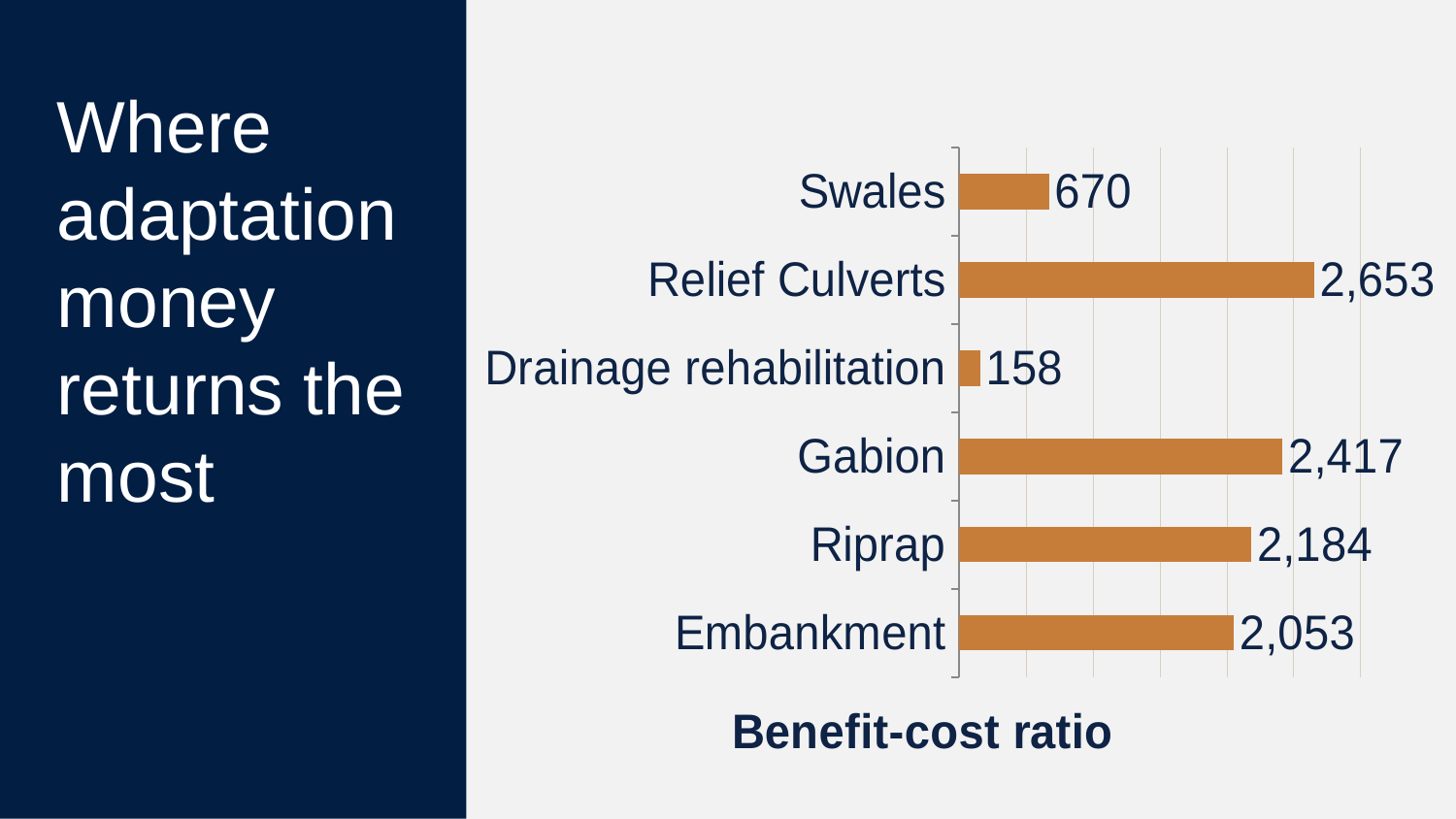
What is the benefit-cost ratio for Riprap? 2,184 What is the benefit-cost ratio for Drainage rehabilitation? 158 What is the difference between the benefit-cost ratios of Relief Culverts and Swales? 1,983 What is the difference between the benefit-cost ratios of Gabion and Embankment? 364 Which category has the highest benefit-cost ratio? Relief Culverts How many categories are shown in the chart? 6 Which has a larger benefit-cost ratio, Riprap or Gabion? Gabion What is the title of the chart? Benefit-cost ratio What kind of chart is shown on the slide? Bar chart What is the benefit-cost ratio for Relief Culverts? 2,653 What is the benefit-cost ratio for Swales? 670 Which category has the lowest benefit-cost ratio? Drainage rehabilitation